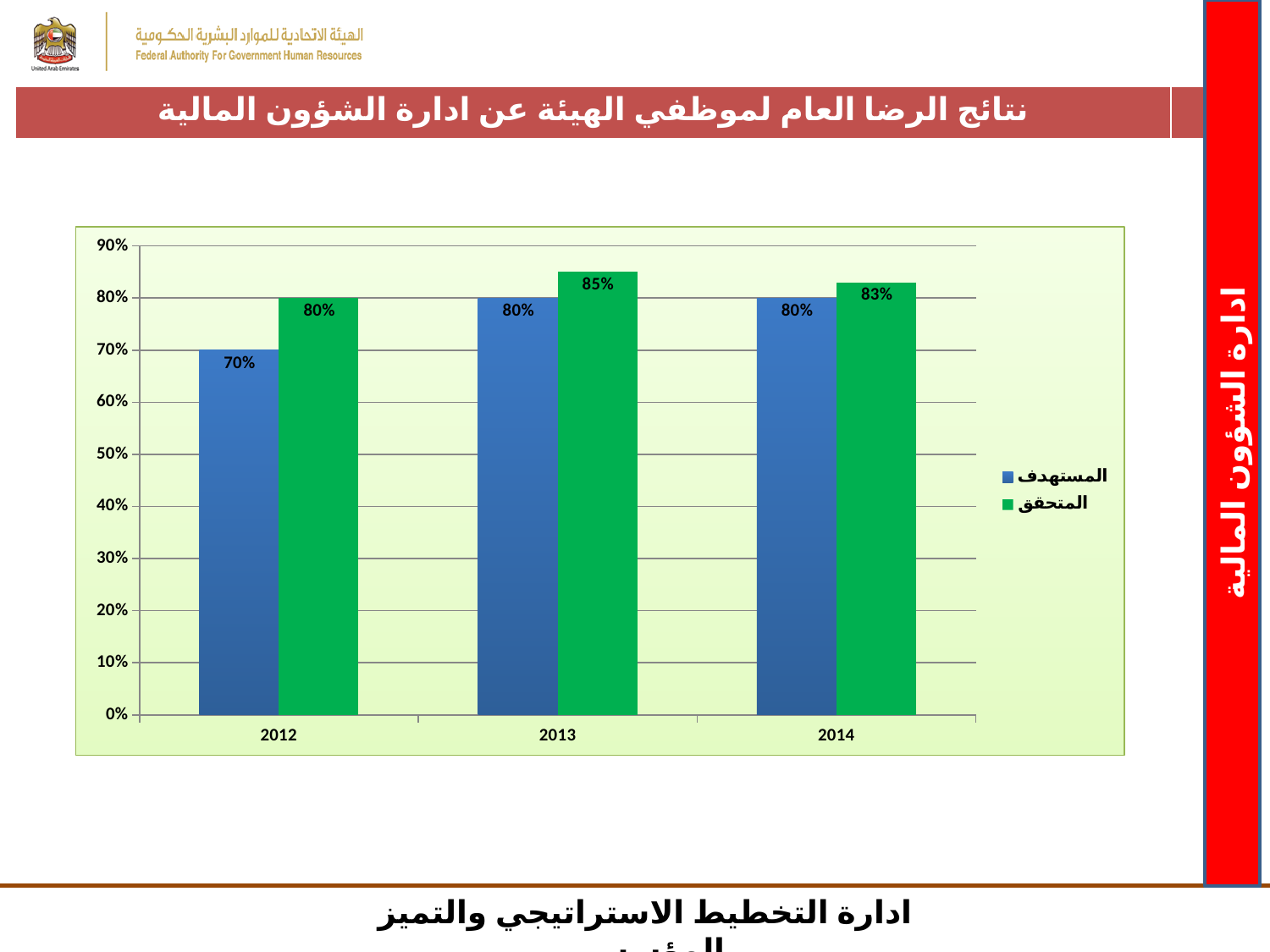
Which is larger in 2013, المستهدف or المتحقق? المتحقق How many years are shown on the x axis? 3 What kind of chart is shown on the slide? Bar chart What is the difference between المتحقق and المستهدف in 2014? 3% What is the difference between المتحقق and المستهدف in 2012? 10% In which year is the المتحقق (achieved) value highest? 2013 What is the value of المتحقق (achieved) for 2014? 83% What is the value of المستهدف (target) for 2012? 70% In which year is the المستهدف (target) value lowest? 2012 What is the value of المتحقق (achieved) for 2013? 85% What is the value of المستهدف (target) for 2014? 80% How many series does the legend list? 2